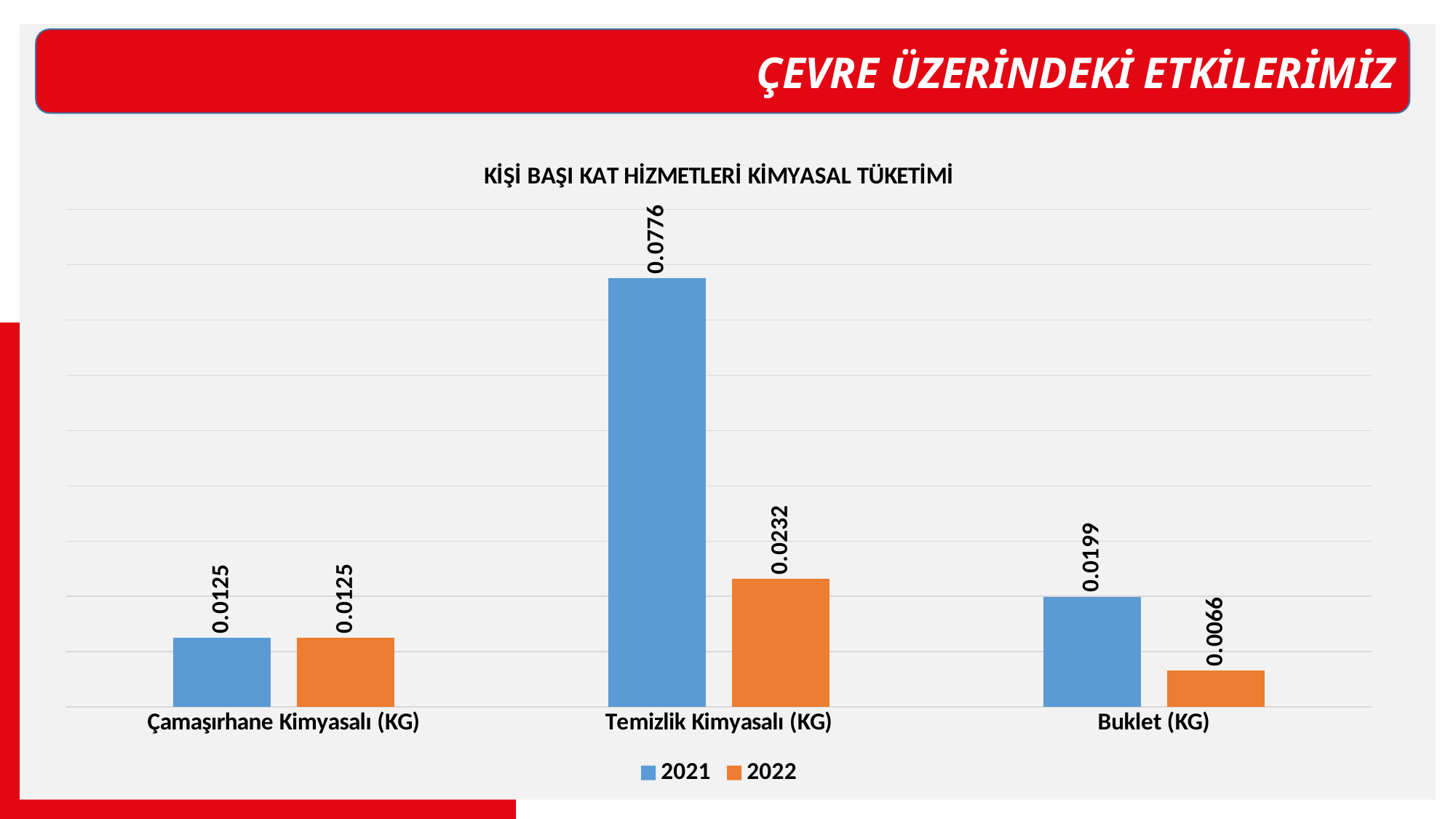
What is the difference between the 2021 and 2022 values for Buklet (KG)? 0.0133 What is the 2021 value for Temizlik Kimyasalı (KG)? 0.0776 How many series does the legend list? 2 What kind of chart is shown on the slide? Bar chart What is the 2022 value for Buklet (KG)? 0.0066 What is the difference between the 2021 and 2022 values for Temizlik Kimyasalı (KG)? 0.0544 Which category has the highest 2021 value? Temizlik Kimyasalı (KG) Which is larger for Buklet (KG), the 2021 value or the 2022 value? 2021 What is the 2021 value for Çamaşırhane Kimyasalı (KG)? 0.0125 Which category has the lowest 2022 value? Buklet (KG) How many categories are shown on the x axis? 3 What is the 2022 value for Temizlik Kimyasalı (KG)? 0.0232